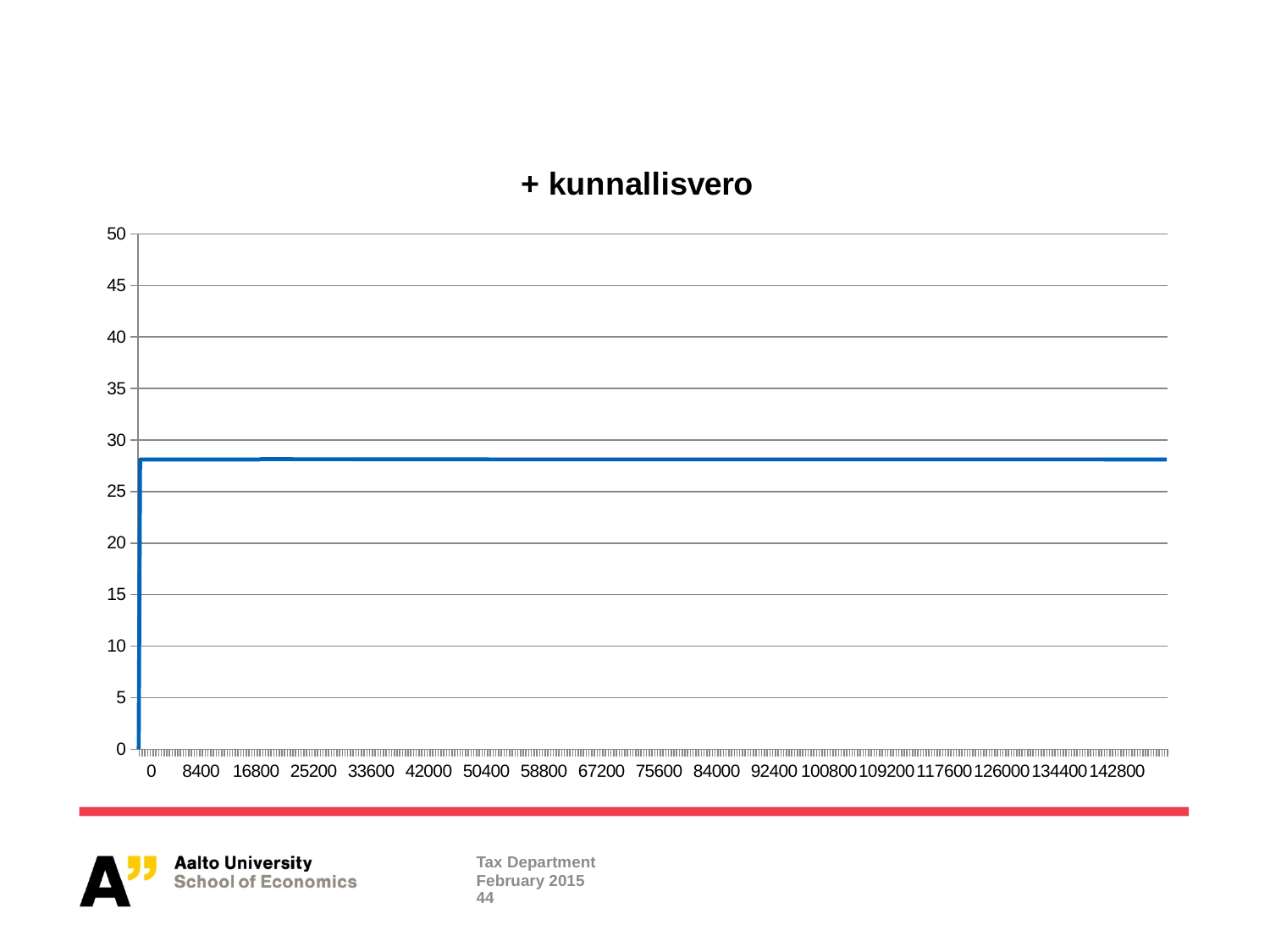
What kind of chart is shown on the slide? line chart Is the value of the line at 42000 greater or less than 20? greater What is the value of the line at x = 0? 0 What is the highest value shown on the vertical axis? 50 Is the value of the line at 84000 greater or less than 25? greater Is the value of the line at 84000 greater or less than 30? less What is the largest value labelled on the horizontal axis? 142800 How many lines are plotted on the chart? 1 What is the title of the chart? + kunnallisvero After the initial jump at 0, does the line rise, fall, or stay flat as the x-axis values increase? stay flat